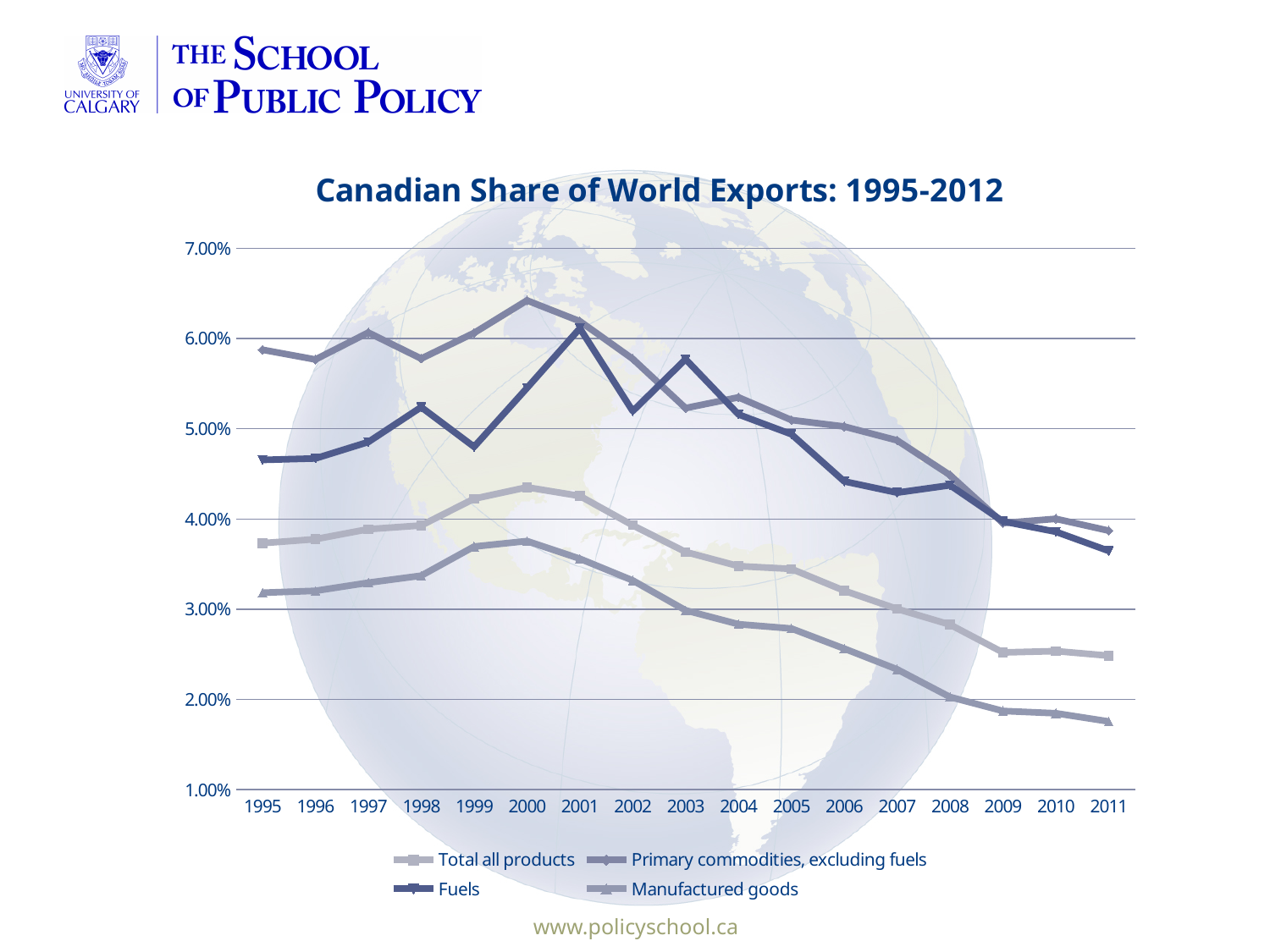
In which year is the Manufactured goods series at its lowest? 2011 Is the value for Manufactured goods in 2011 greater or less than 2.00%? less In which year does the Fuels series reach its highest value? 2001 Does the Manufactured goods series rise or fall from 2000 to 2011? fall Is the value for Primary commodities, excluding fuels in 2000 greater or less than 6.00%? greater In which year does the Primary commodities, excluding fuels series reach its highest value? 2000 What kind of chart is shown on the slide? line chart How many years are shown along the x axis? 17 What is the title of the chart? Canadian Share of World Exports: 1995-2012 How many series does the legend list? 4 Which series has the lowest value in 2011? Manufactured goods In 2003, which is larger: Fuels or Primary commodities, excluding fuels? Fuels